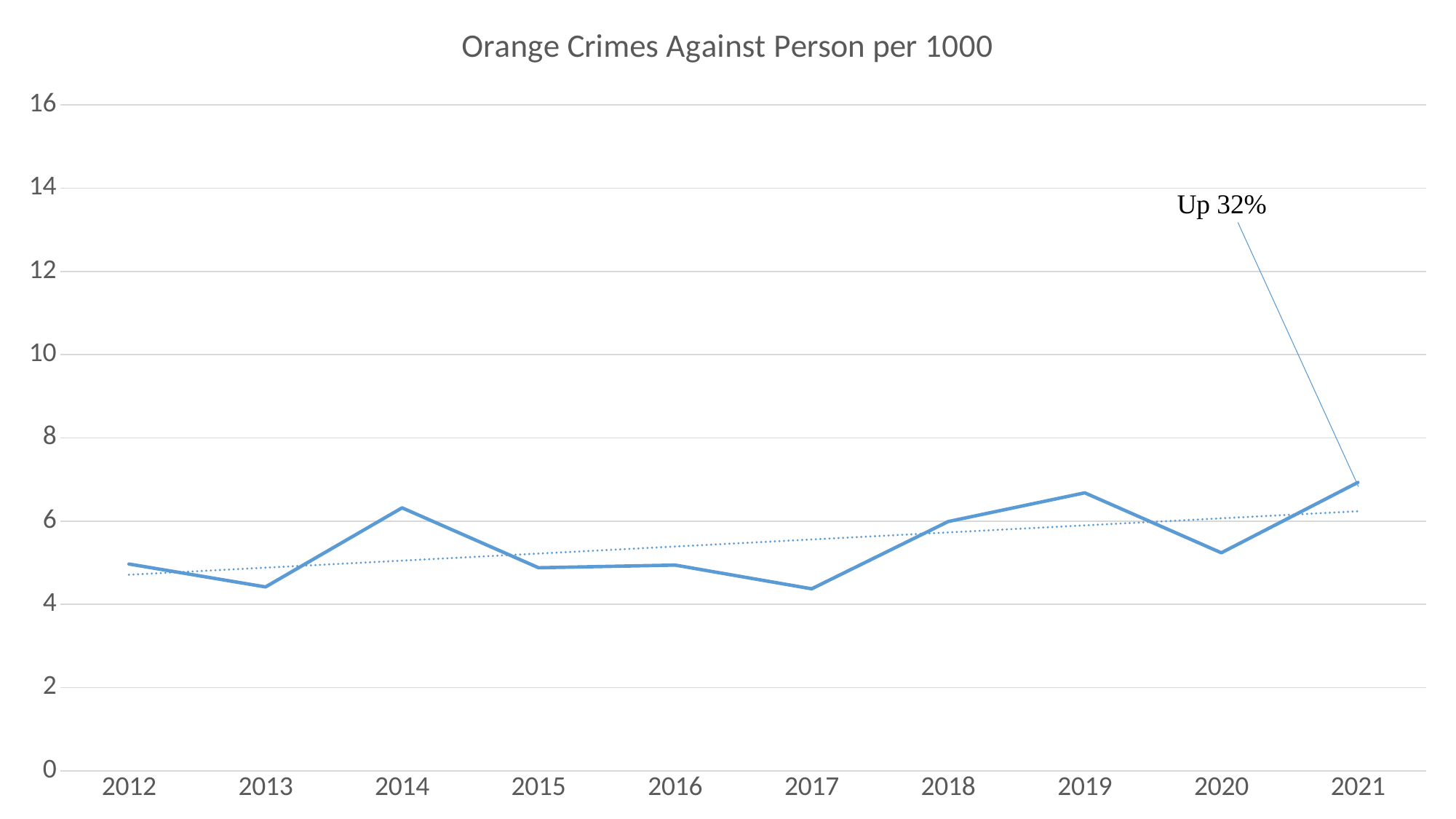
Is the value for 2020 greater or less than 6? less How many years are plotted along the x axis? 10 Is the value for 2014 greater or less than 6? greater Which year has the larger value, 2014 or 2015? 2014 Which year has the highest value on the chart? 2021 Is the value for 2017 greater or less than 6? less Does the dotted trend line rise or fall from 2012 to 2021? rise What does the text annotation pointing to the 2021 data point say? Up 32% What kind of chart is shown on the slide? line chart Which year has the larger value, 2019 or 2020? 2019 What is the title of the chart? Orange Crimes Against Person per 1000